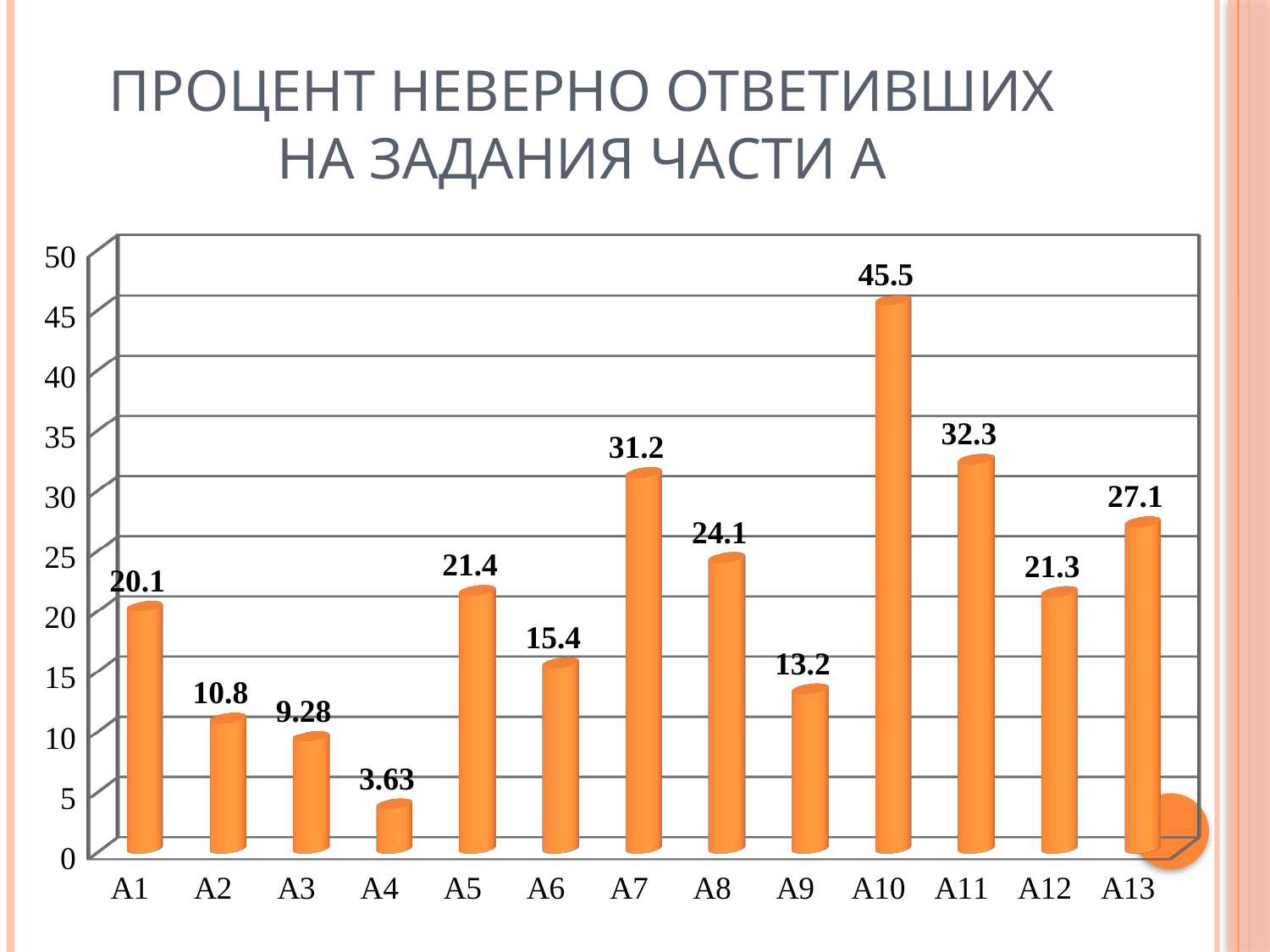
Which is larger, the value for A8 or the value for A13? A13 How many categories are shown on the x axis? 13 Which category has the highest value? A10 What is the value for A4? 3.63 Is the value for A6 greater or less than 20? less What is the title of the chart on the slide? ПРОЦЕНТ НЕВЕРНО ОТВЕТИВШИХ НА ЗАДАНИЯ ЧАСТИ А What is the difference between the values for A10 and A11? 13.2 What is the difference between the values for A2 and A3? 1.52 Which category has the lowest value? A4 What is the value for A7? 31.2 What is the value for A10? 45.5 What kind of chart is shown on the slide? bar chart